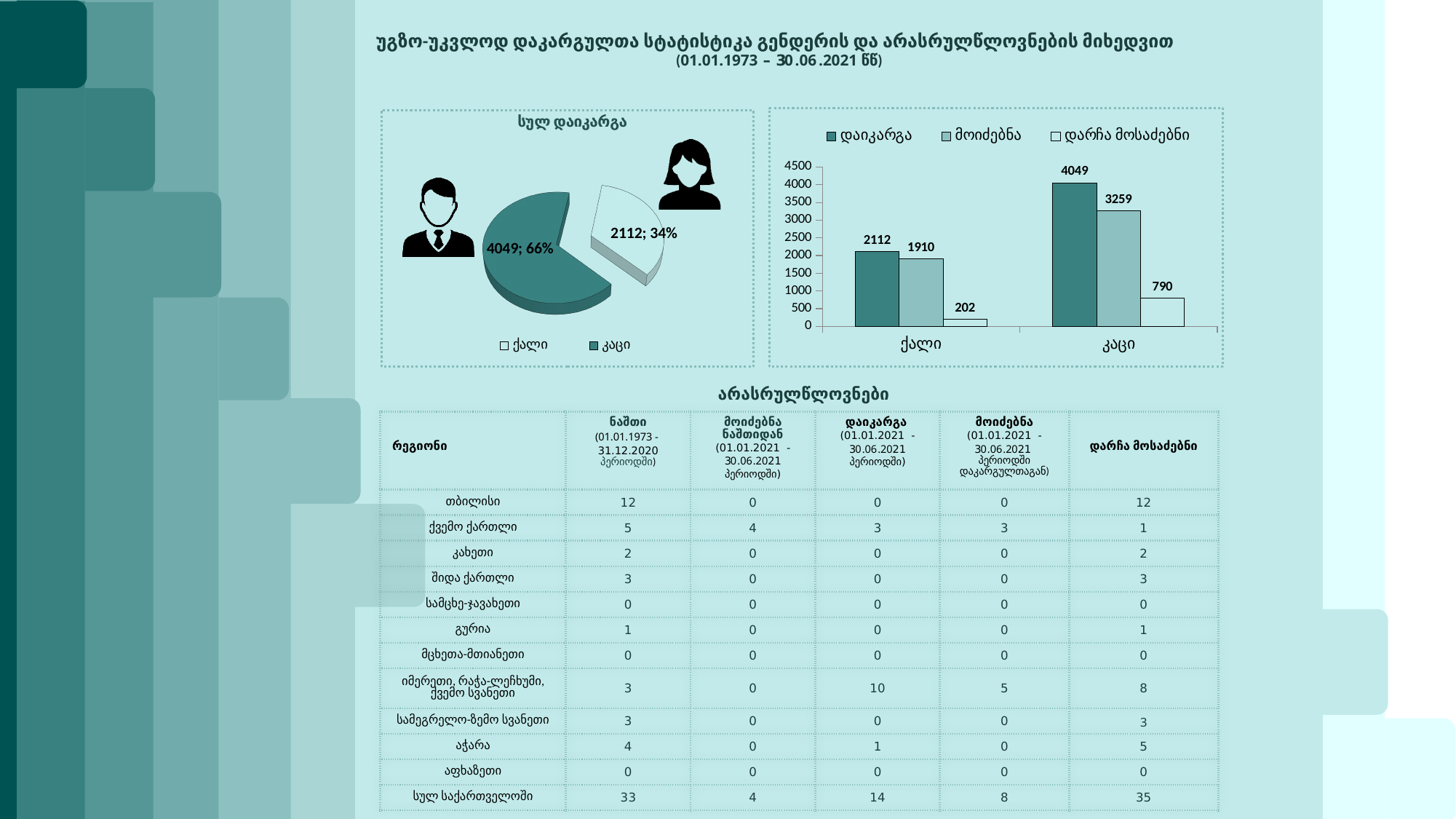
In the bar chart on the right, what is the difference between "დაიკარგა" and "მოიძებნა" for "კაცი"? 790 In the pie chart titled "სულ დაიკარგა", which slice is larger, "ქალი" or "კაცი"? კაცი In the bar chart on the right, what is the value of "დაიკარგა" for "კაცი"? 4049 In the pie chart titled "სულ დაიკარგა", what value and share are shown for the "კაცი" slice? 4049; 66% In the bar chart on the right, what is the difference between "დარჩა მოსაძებნი" for "კაცი" and for "ქალი"? 588 In the bar chart on the right, how many series does the legend list? 3 In the pie chart titled "სულ დაიკარგა", what share of the pie does the "ქალი" slice have? 34% In the pie chart titled "სულ დაიკარგა", how many slices are there? 2 What type of chart is shown on the right side of the slide? Bar chart In the bar chart on the right, which category has the lowest "დარჩა მოსაძებნი" value? ქალი In the bar chart on the right, what is the value of "დარჩა მოსაძებნი" for "კაცი"? 790 In the bar chart on the right, what is the value of "მოიძებნა" for "ქალი"? 1910